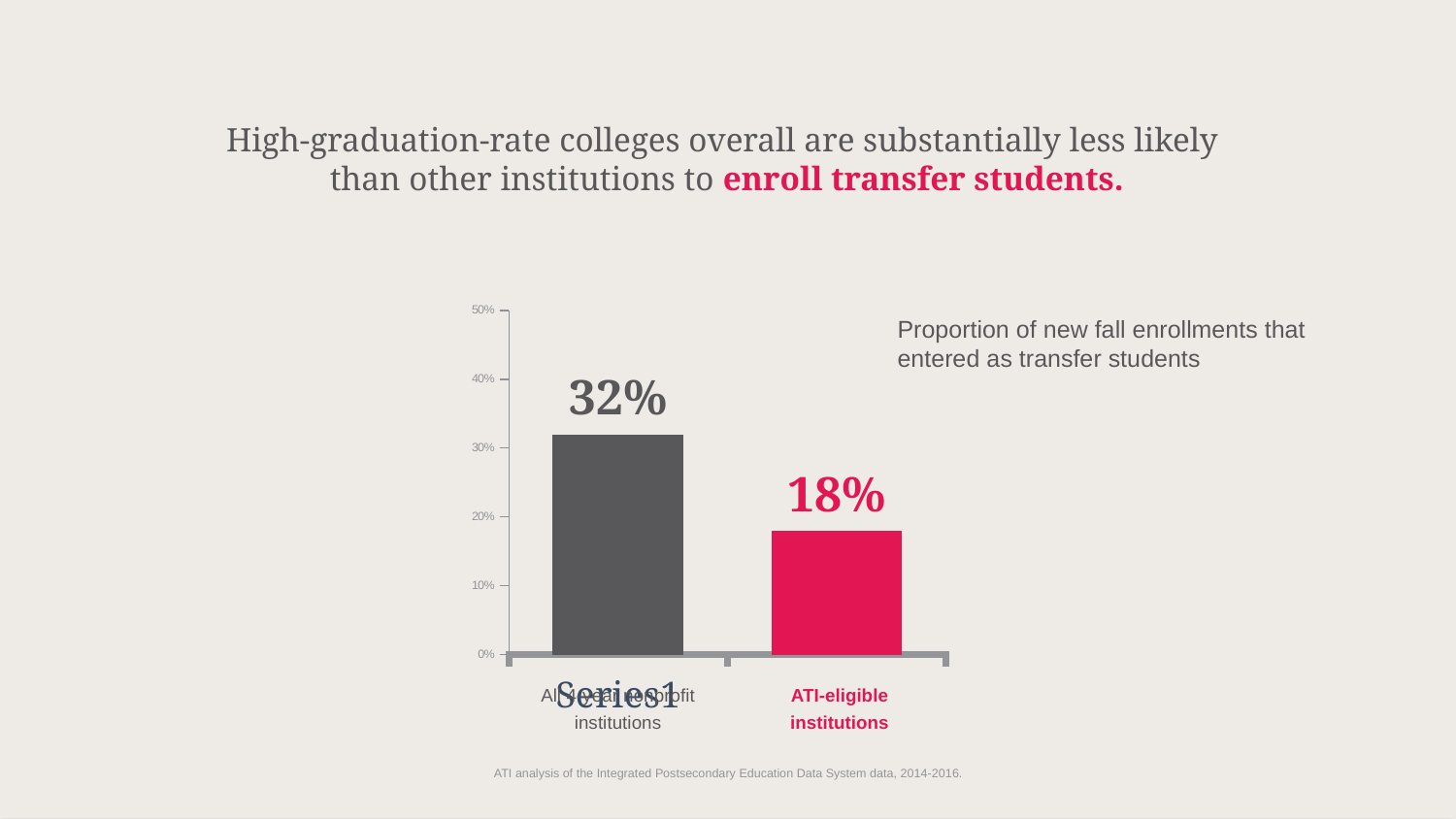
What is the value shown for the left bar (All 4-year nonprofit institutions)? 32% Which category has the lowest value? ATI-eligible institutions How many bars are plotted in the chart? 2 What is the highest value shown on the y-axis? 50% What does the chart measure, according to the text next to it? Proportion of new fall enrollments that entered as transfer students What kind of chart is shown on the slide? Bar chart Which category has the highest value? All 4-year nonprofit institutions What is the value for ATI-eligible institutions? 18% Which is larger: the value for All 4-year nonprofit institutions or the value for ATI-eligible institutions? All 4-year nonprofit institutions What is the difference between the value for All 4-year nonprofit institutions and the value for ATI-eligible institutions? 14% Is the value for ATI-eligible institutions greater or less than 20%? less Is the value for All 4-year nonprofit institutions greater or less than 30%? greater